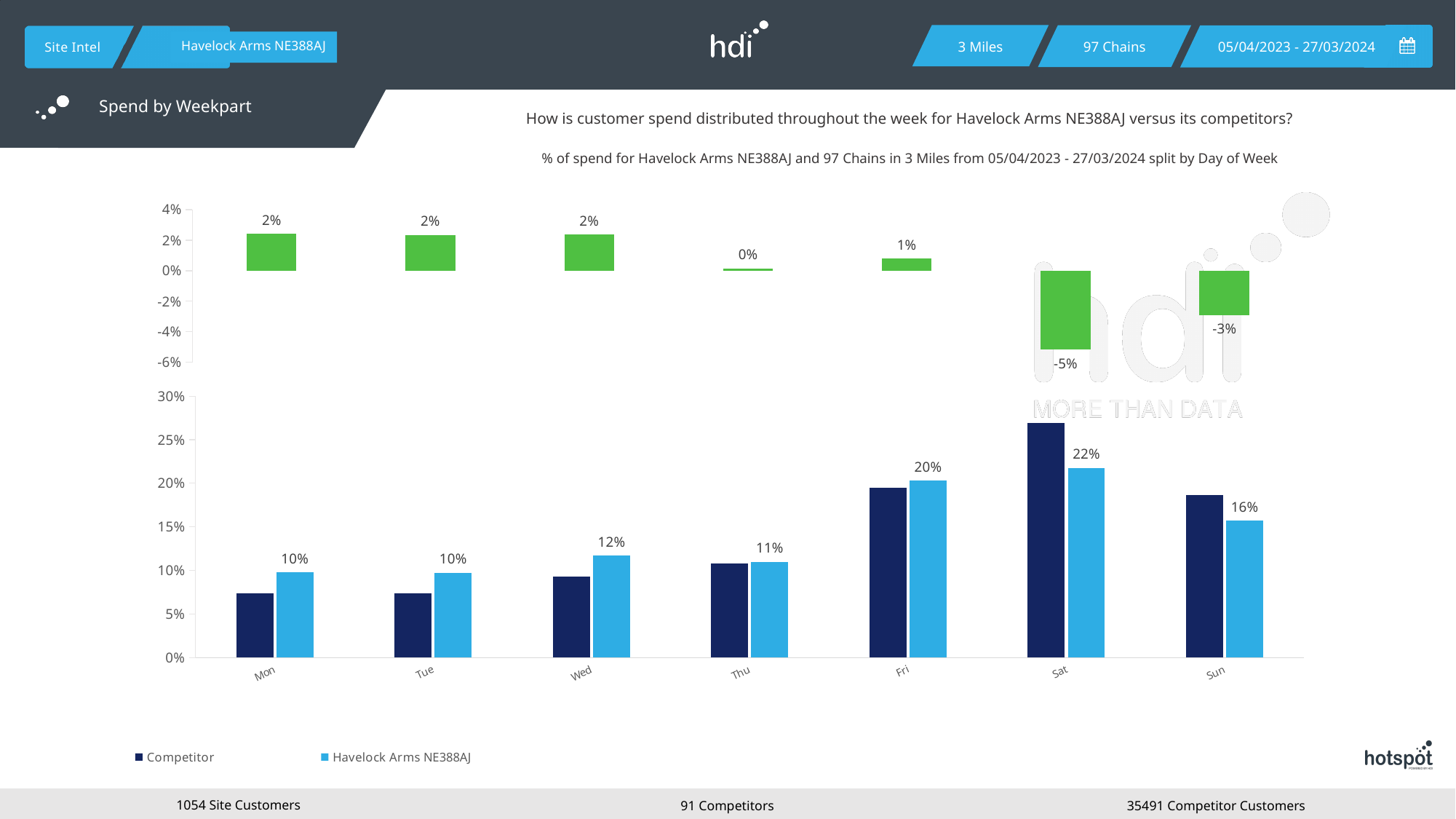
In the bottom chart, is the Competitor value for Sat greater or less than 25%? greater In the top chart, what is the value shown for Sat? -5% In the bottom chart, which is larger on Sat: the Competitor value or the Havelock Arms NE388AJ value? Competitor In the bottom chart, what is the difference between the Havelock Arms NE388AJ values for Sat and Fri? 2% In the bottom chart, on which day is the Havelock Arms NE388AJ value highest? Sat How many series does the legend of the bottom chart list? 2 In the bottom chart, is the Competitor value for Mon greater or less than 10%? less What type of chart is the bottom chart? Bar chart In the bottom chart, what is the value for Havelock Arms NE388AJ on Wed? 12% In the bottom chart, what is the value for Havelock Arms NE388AJ on Sat? 22% In the top chart, which day has the lowest value? Sat In the top chart, what is the value shown for Thu? 0%